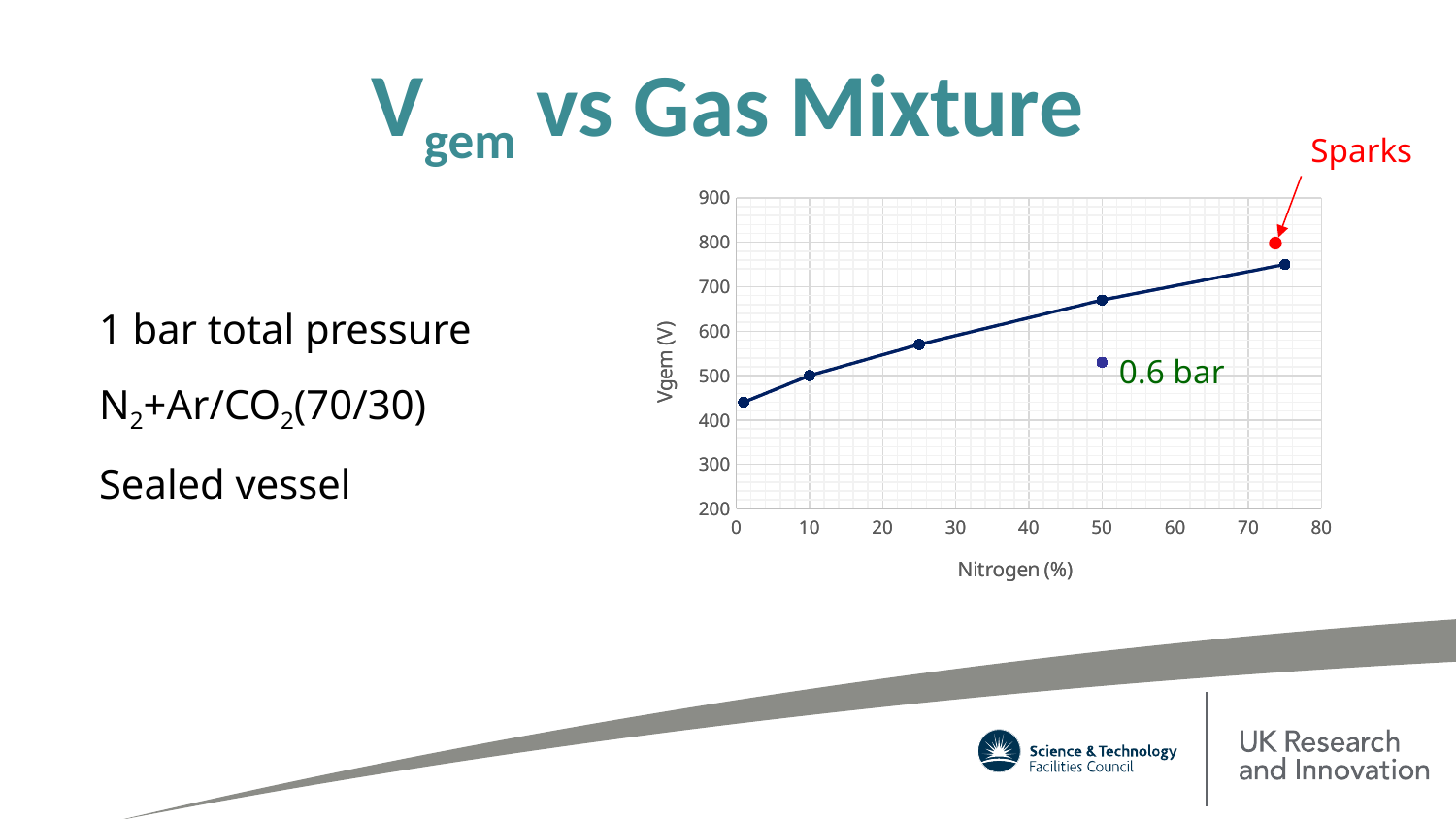
Is the Vgem value at 75% nitrogen on the line greater or less than 700? greater Is the Vgem value at 10% nitrogen greater or less than 600? less How many data points are connected by the line in the chart? 5 What is the label of the x axis of the chart? Nitrogen (%) Is the Vgem value at 50% nitrogen on the line greater or less than 600? greater What kind of chart is shown on the slide? line chart Does Vgem rise or fall as the nitrogen percentage increases along the x axis? rise What is the title of the chart? Vgem vs Gas Mixture Which has the larger Vgem value on the line: 25% nitrogen or 50% nitrogen? 50% nitrogen